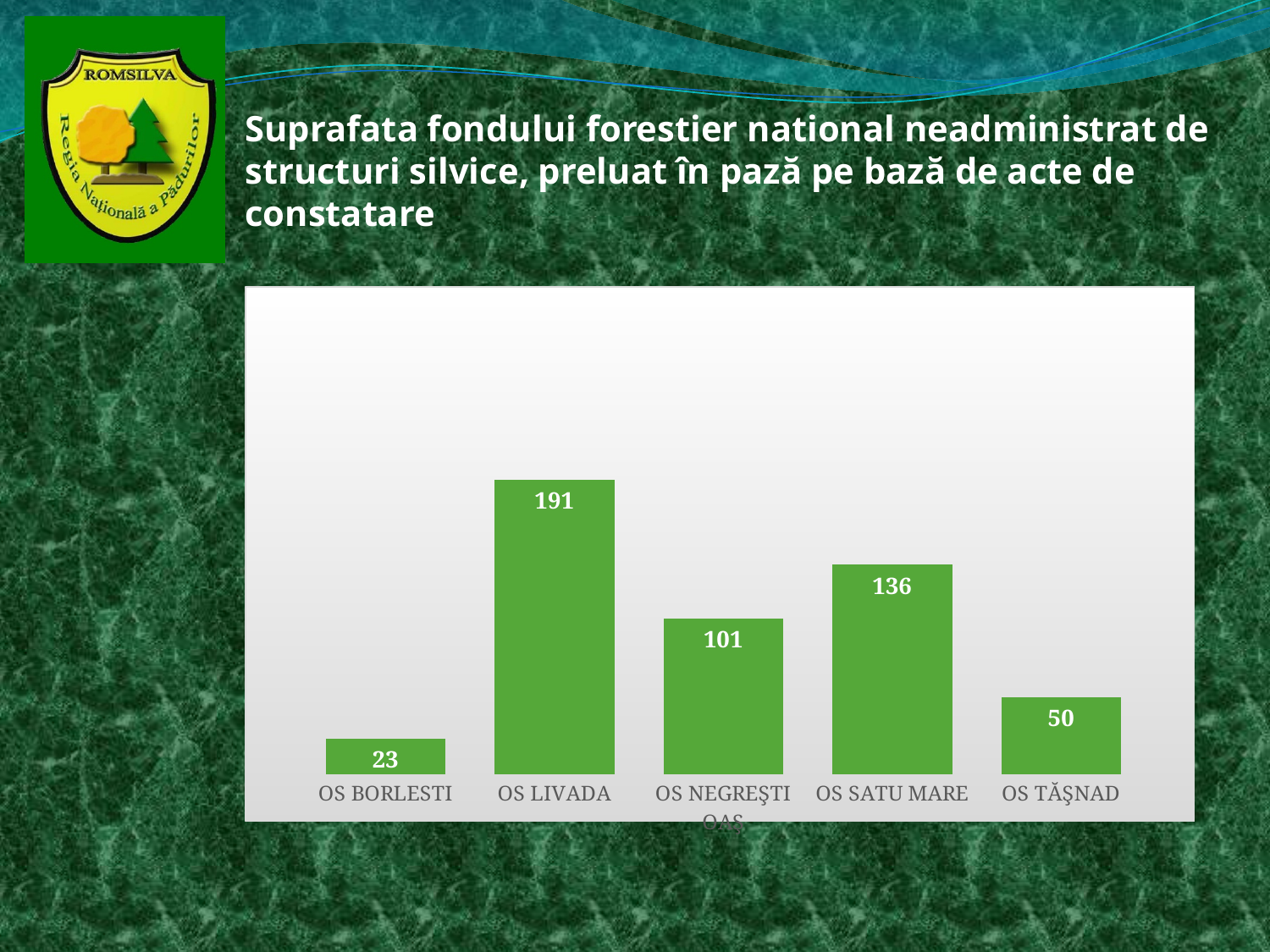
What is the value for OS TĂŞNAD? 50 What is the difference between the values for OS NEGREŞTI OAŞ and OS TĂŞNAD? 51 What is the value for OS BORLESTI? 23 Which is larger, the value for OS NEGREŞTI OAŞ or the value for OS SATU MARE? OS SATU MARE What is the value for OS LIVADA? 191 Which category has the highest value? OS LIVADA How many categories are shown in the chart? 5 What colour are the bars in the chart? green Which category has the lowest value? OS BORLESTI What is the value for OS SATU MARE? 136 What is the difference between the values for OS LIVADA and OS SATU MARE? 55 What kind of chart is shown on the slide? bar chart